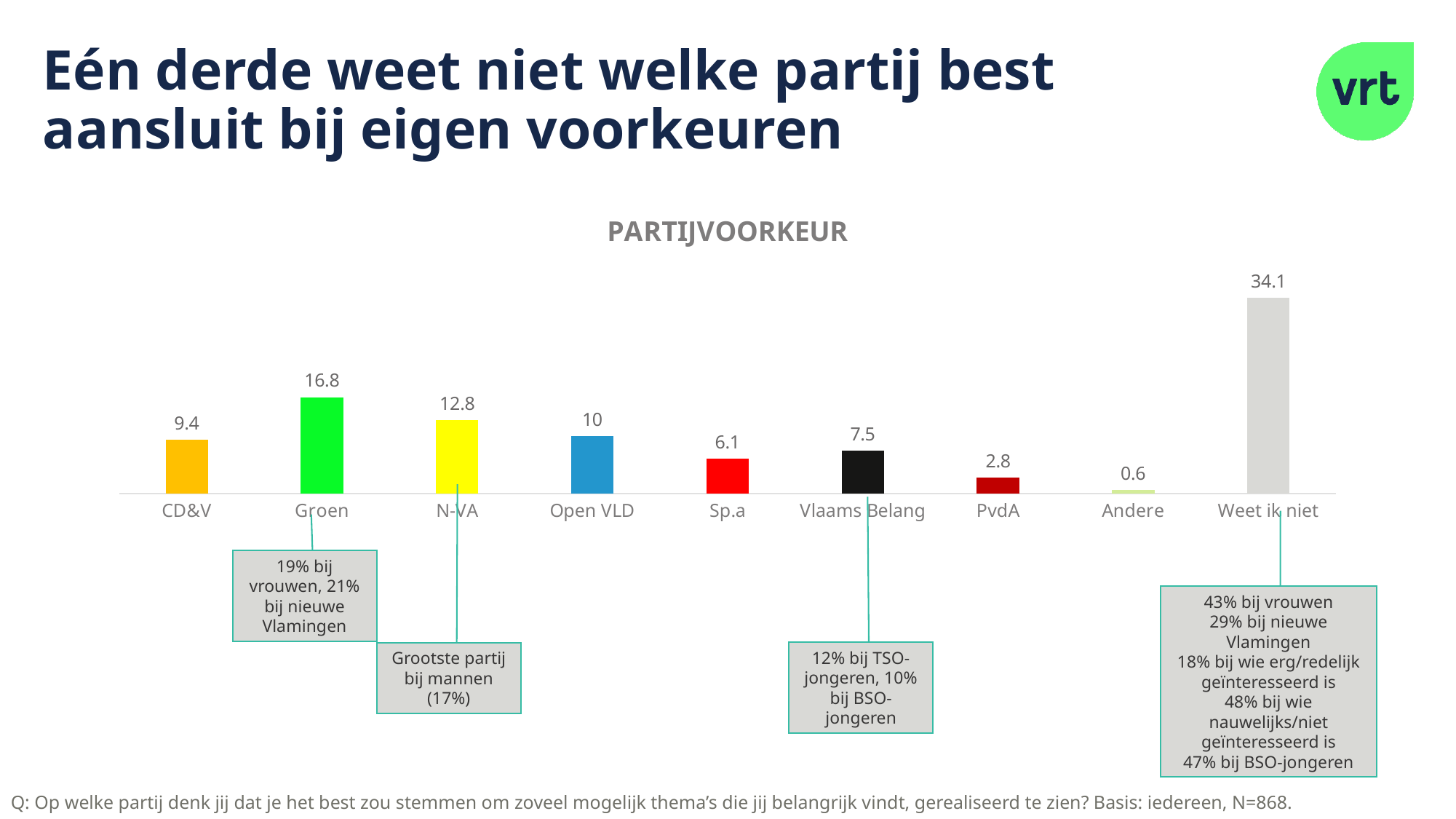
What kind of chart is the PARTIJVOORKEUR chart? Bar chart What is the difference between the values for Weet ik niet and CD&V in the PARTIJVOORKEUR chart? 24.7 What is the value for Weet ik niet in the PARTIJVOORKEUR chart? 34.1 Which category has the highest value in the PARTIJVOORKEUR chart? Weet ik niet How many categories are shown in the PARTIJVOORKEUR chart? 9 What is the title of the chart on the slide? PARTIJVOORKEUR What is the value for Vlaams Belang in the PARTIJVOORKEUR chart? 7.5 What is the difference between the values for Groen and N-VA in the PARTIJVOORKEUR chart? 4 What is the value for Groen in the PARTIJVOORKEUR chart? 16.8 Which has a larger value in the PARTIJVOORKEUR chart, PvdA or Vlaams Belang? Vlaams Belang Which category has the lowest value in the PARTIJVOORKEUR chart? Andere Which has a larger value in the PARTIJVOORKEUR chart, Open VLD or Sp.a? Open VLD